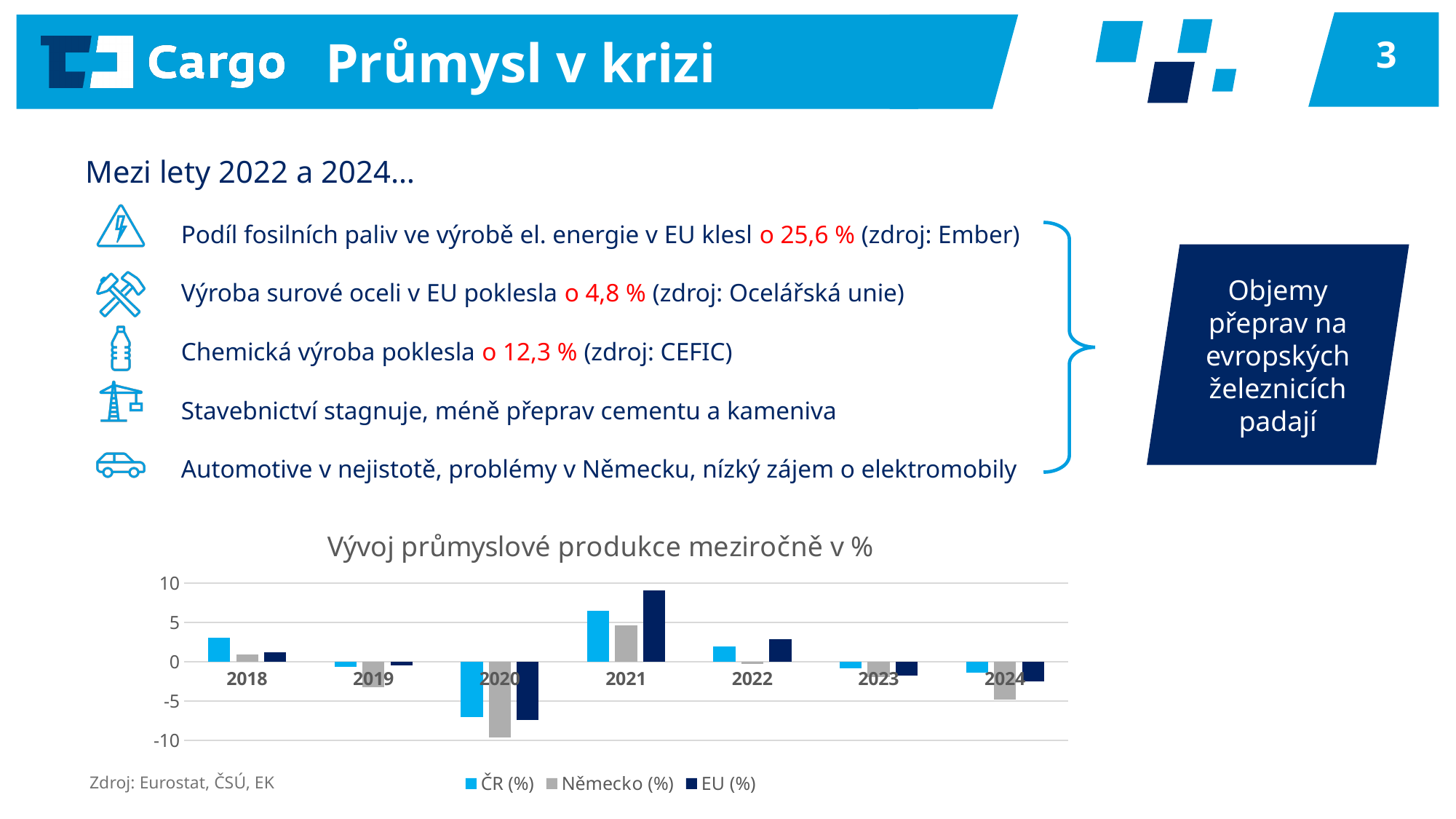
In 2024, which is lower: the Německo (%) value or the ČR (%) value? Německo (%) In 2021, which is larger: the EU (%) value or the ČR (%) value? EU (%) Is the value for EU (%) in 2021 greater or less than 5? greater How many years are shown on the x axis of the chart? 7 How many series does the chart legend list? 3 In which year is the EU (%) value highest? 2021 In which year is the Německo (%) value lowest? 2020 Is the value for ČR (%) in 2018 greater or less than 5? less Is the value for Německo (%) in 2020 greater or less than -5? less What kind of chart is shown on the slide? bar chart What is the title of the chart? Vývoj průmyslové produkce meziročně v % Which colour represents the EU (%) series in the chart? dark navy blue